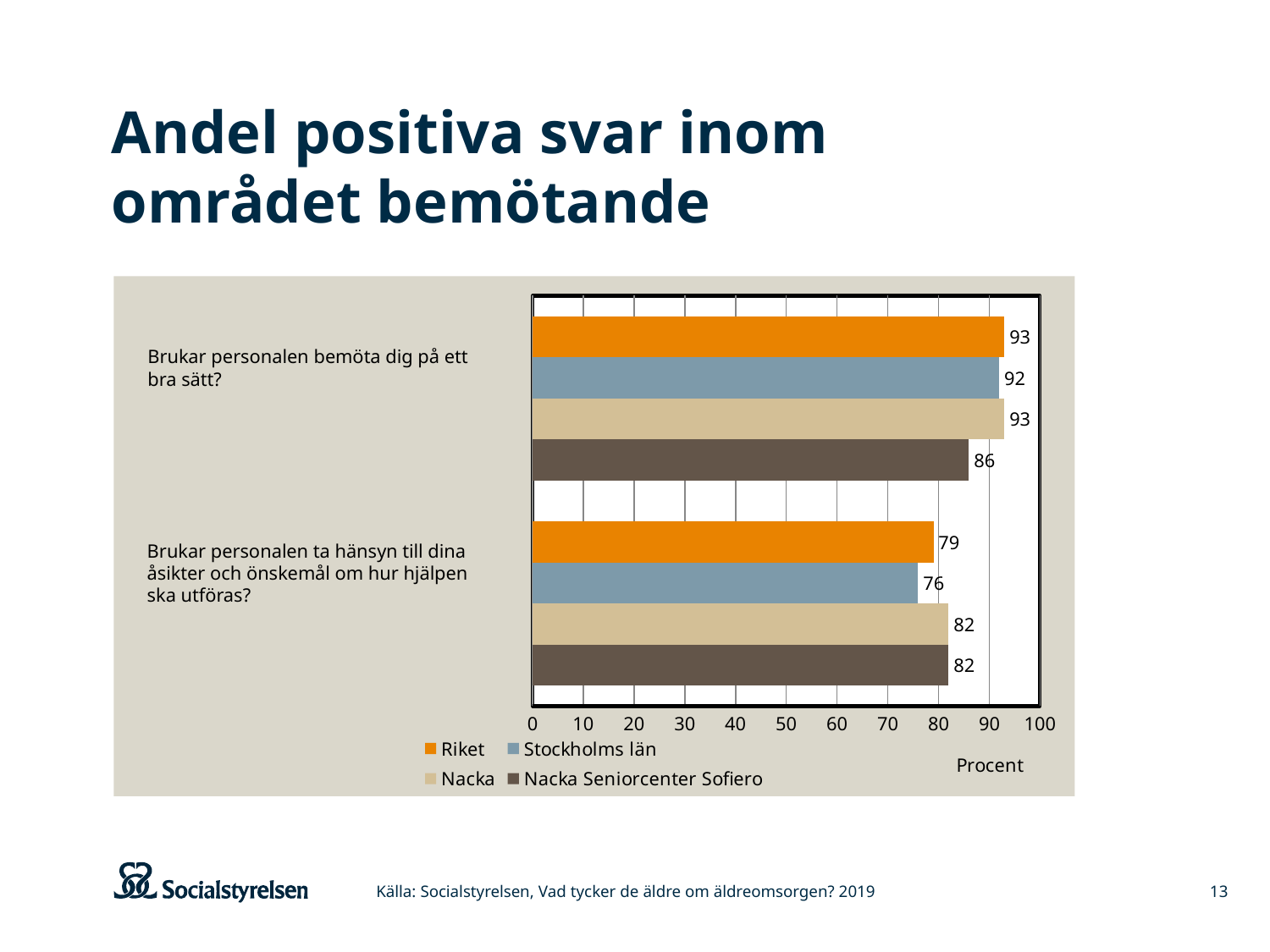
Which is larger: the Riket value or the Stockholms län value on the question "Brukar personalen ta hänsyn till dina åsikter och önskemål om hur hjälpen ska utföras?"? Riket What is the difference between the Nacka value and the Stockholms län value on the question "Brukar personalen ta hänsyn till dina åsikter och önskemål om hur hjälpen ska utföras?"? 6 What unit is labelled on the horizontal axis of the chart? Procent What is the value for Stockholms län on the question "Brukar personalen ta hänsyn till dina åsikter och önskemål om hur hjälpen ska utföras?"? 76 Which series has the lowest value on the question "Brukar personalen bemöta dig på ett bra sätt?"? Nacka Seniorcenter Sofiero How many series does the legend list? 4 How many question categories are shown on the chart? 2 What is the value for Nacka Seniorcenter Sofiero on the question "Brukar personalen bemöta dig på ett bra sätt?"? 86 What is the difference between the Riket value and the Nacka Seniorcenter Sofiero value on the question "Brukar personalen bemöta dig på ett bra sätt?"? 7 What type of chart is shown on the slide? bar chart Which series has the lowest value on the question "Brukar personalen ta hänsyn till dina åsikter och önskemål om hur hjälpen ska utföras?"? Stockholms län What is the value for Riket on the question "Brukar personalen bemöta dig på ett bra sätt?"? 93